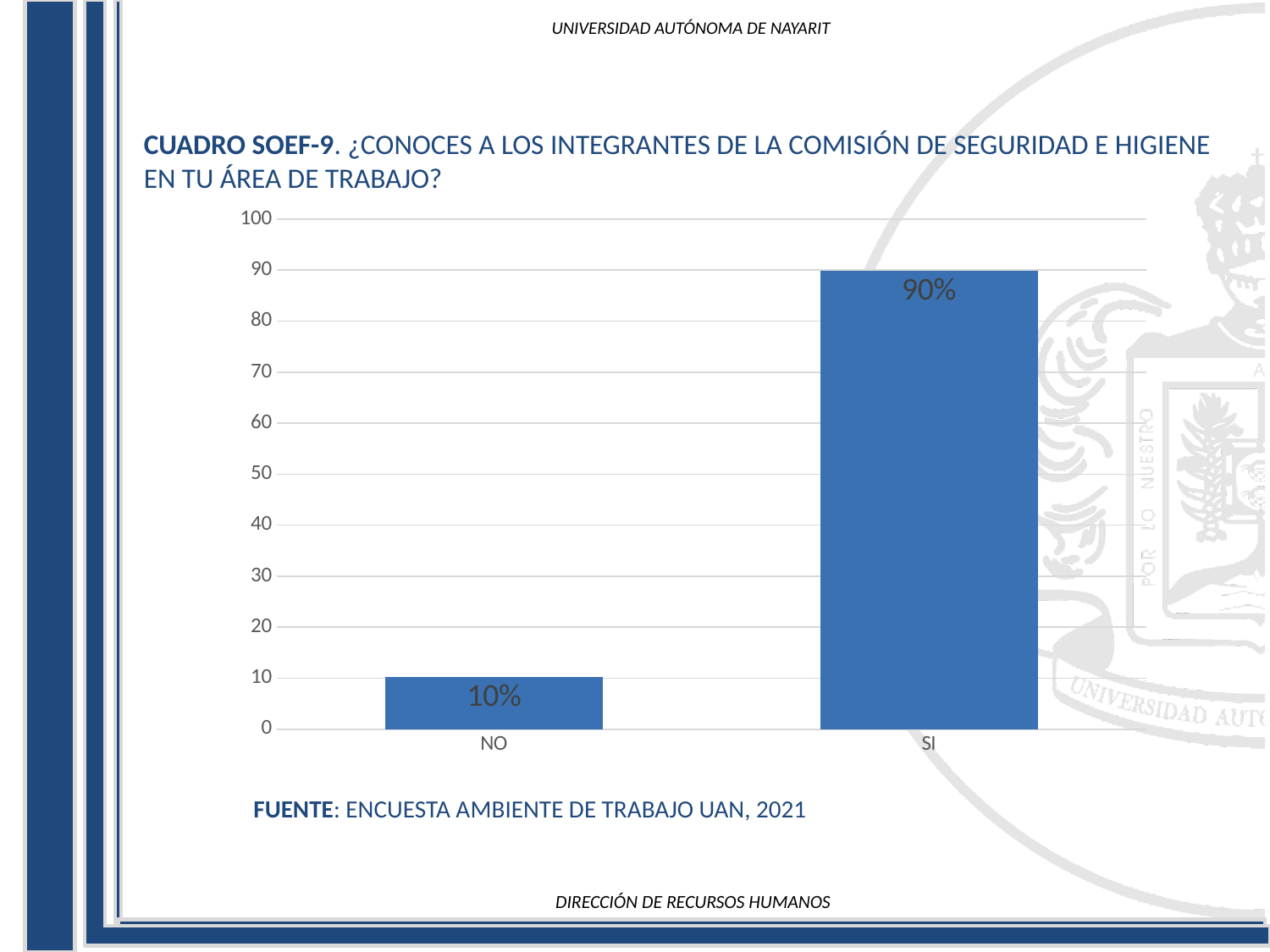
What is the source cited below the chart? ENCUESTA AMBIENTE DE TRABAJO UAN, 2021 Which is larger, the value for NO or the value for SI? SI What kind of chart is shown on the slide? bar chart What is the value for SI? 90% Is the value for SI greater or less than 50? greater Which category has the lowest value? NO Is the value for NO greater or less than 20? less What is the maximum value shown on the y axis? 100 What is the difference between the values for SI and NO? 80% What is the value for NO? 10% How many categories are shown on the x axis? 2 Which category has the highest value? SI